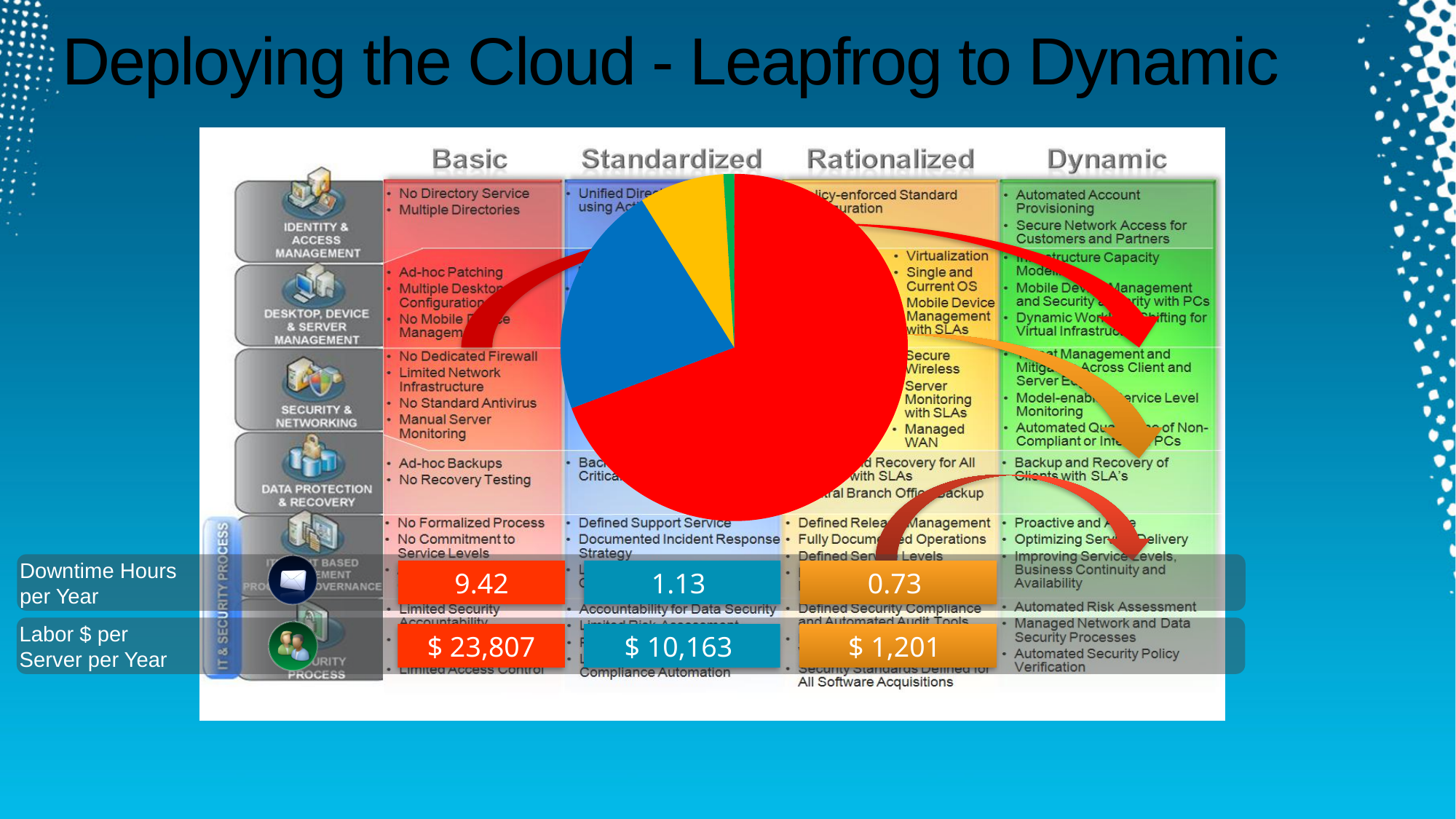
How many slices does the pie chart have? 4 Is the red slice of the pie chart greater or less than half of the pie? greater In the pie chart, which slice is larger, the blue slice or the yellow slice? blue Does the pie chart display a legend? No What kind of chart is shown on the slide? pie chart Which colour slice is the smallest in the pie chart? green Which colour slice is the largest in the pie chart? red